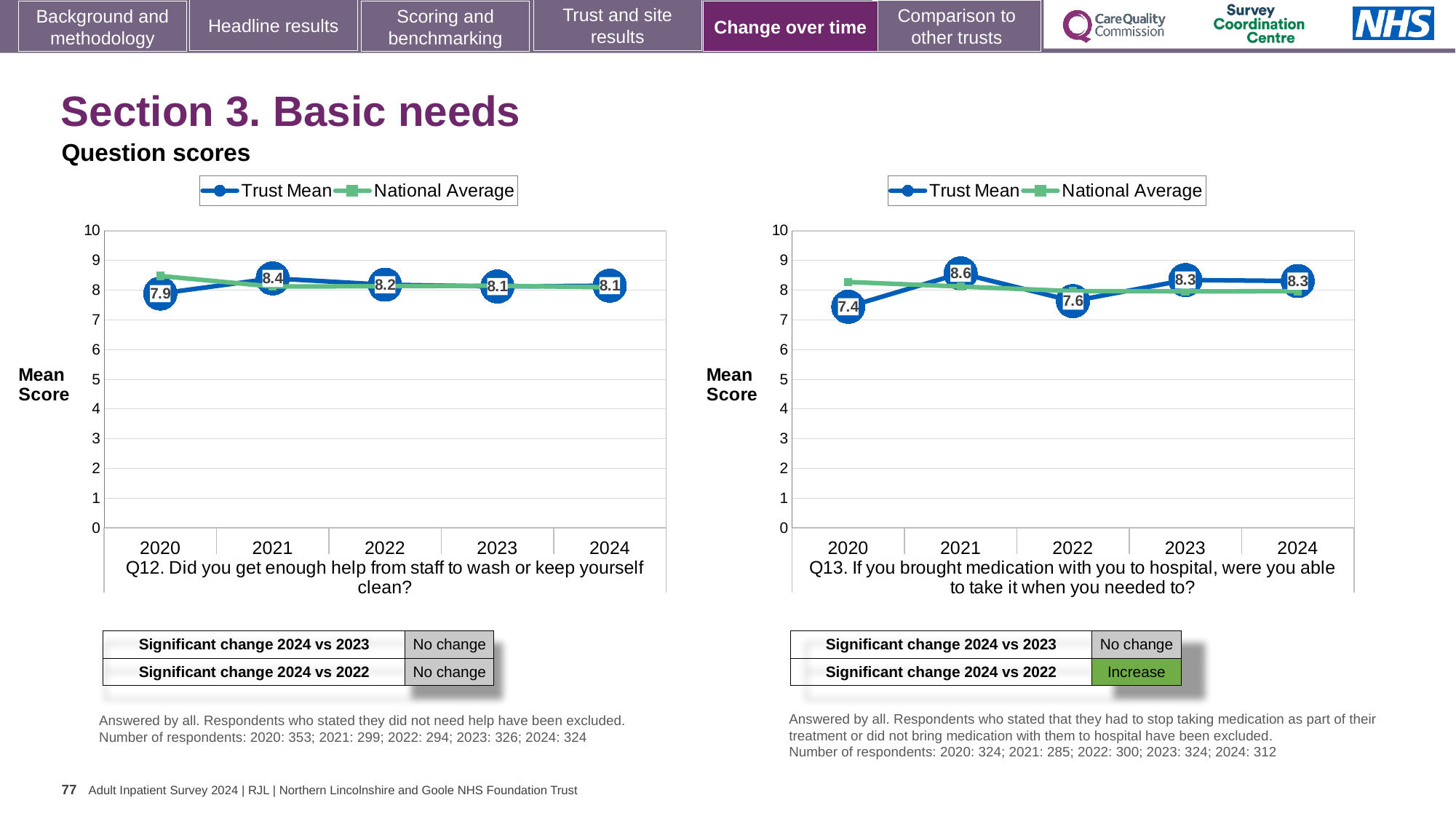
In the Q12 chart (left), what is the Trust Mean score for 2021? 8.4 In the Q13 chart (right), is the Trust Mean score for 2021 or 2022 larger? 2021 In the Q13 chart (right), what is the Trust Mean score for 2022? 7.6 In the Q12 chart (left), what is the difference between the Trust Mean scores for 2021 and 2020? 0.5 In the Q12 chart (left), what is the Trust Mean score for 2020? 7.9 In the Q12 chart (left), which year has the lowest Trust Mean score? 2020 In the Q12 chart (left), which year has the highest Trust Mean score? 2021 In the Q13 chart (right), what is the difference between the Trust Mean scores for 2021 and 2020? 1.2 In the Q13 chart (right), which year has the highest Trust Mean score? 2021 What kind of chart is the Q13 chart (right)? Line chart How many series does the legend of the Q12 chart (left) list? 2 In the Q13 chart (right), which year has the lowest Trust Mean score? 2020